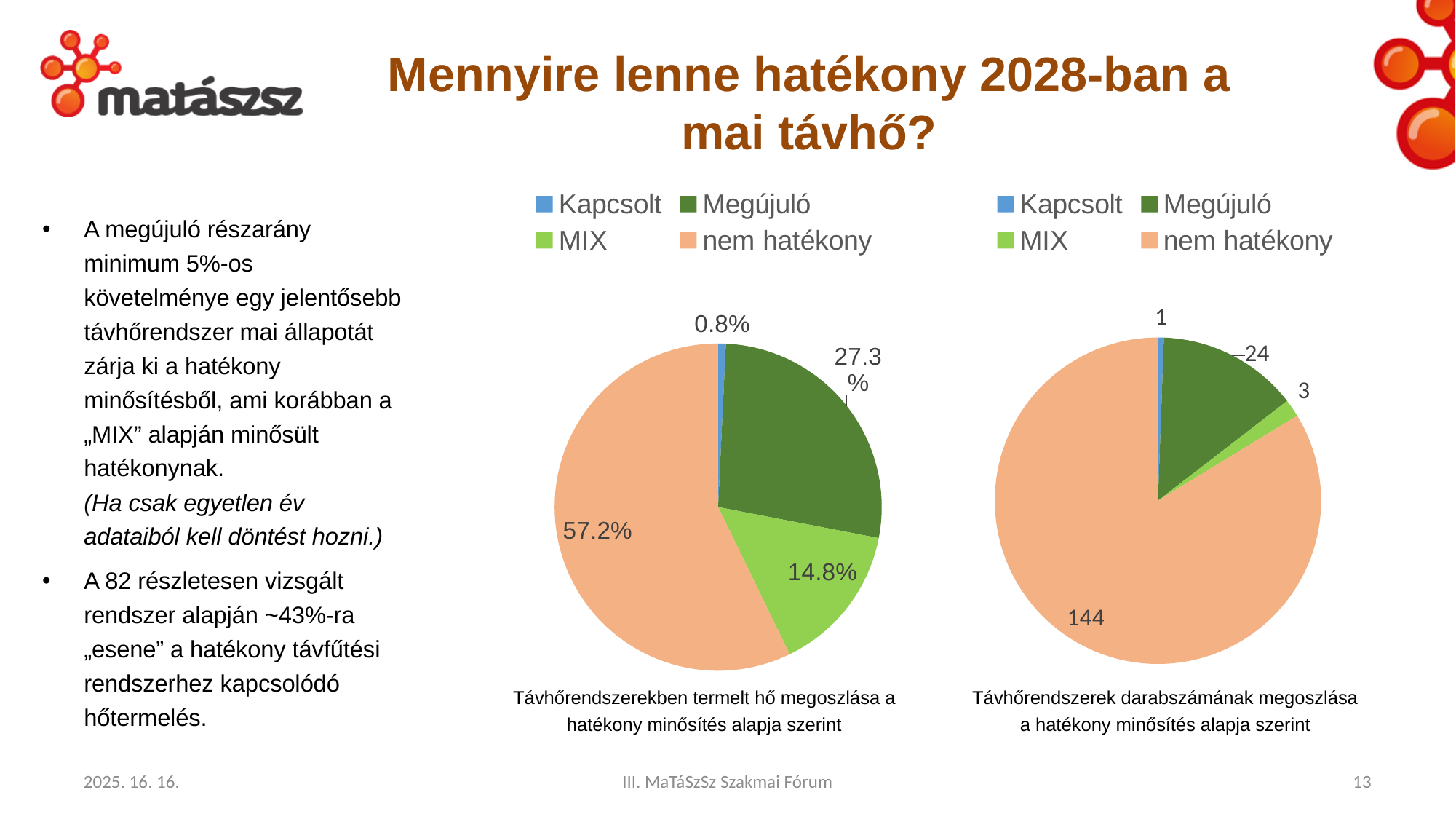
In the left pie chart (heat distribution), what share is labelled for the 'Megújuló' slice? 27.3% How many series does the legend of the left pie chart list? 4 In the right pie chart (number of systems), which category has the largest slice? nem hatékony In the left pie chart (heat distribution), what share is labelled for the 'nem hatékony' slice? 57.2% In the right pie chart (number of systems), what is the difference between the 'Megújuló' and 'MIX' values? 21 In the right pie chart (number of systems), what value is labelled for 'nem hatékony'? 144 In the left pie chart (heat distribution), what share is labelled for the 'MIX' slice? 14.8% In the left pie chart (heat distribution), which category has the smallest slice? Kapcsolt In the right pie chart (number of systems), what value is labelled for 'Megújuló'? 24 What type of chart is used on the right side of the slide? Pie chart In the left pie chart (heat distribution), what is the combined share of 'Megújuló' and 'MIX'? 42.1% In the right pie chart (number of systems), which is larger, 'MIX' or 'Kapcsolt'? MIX